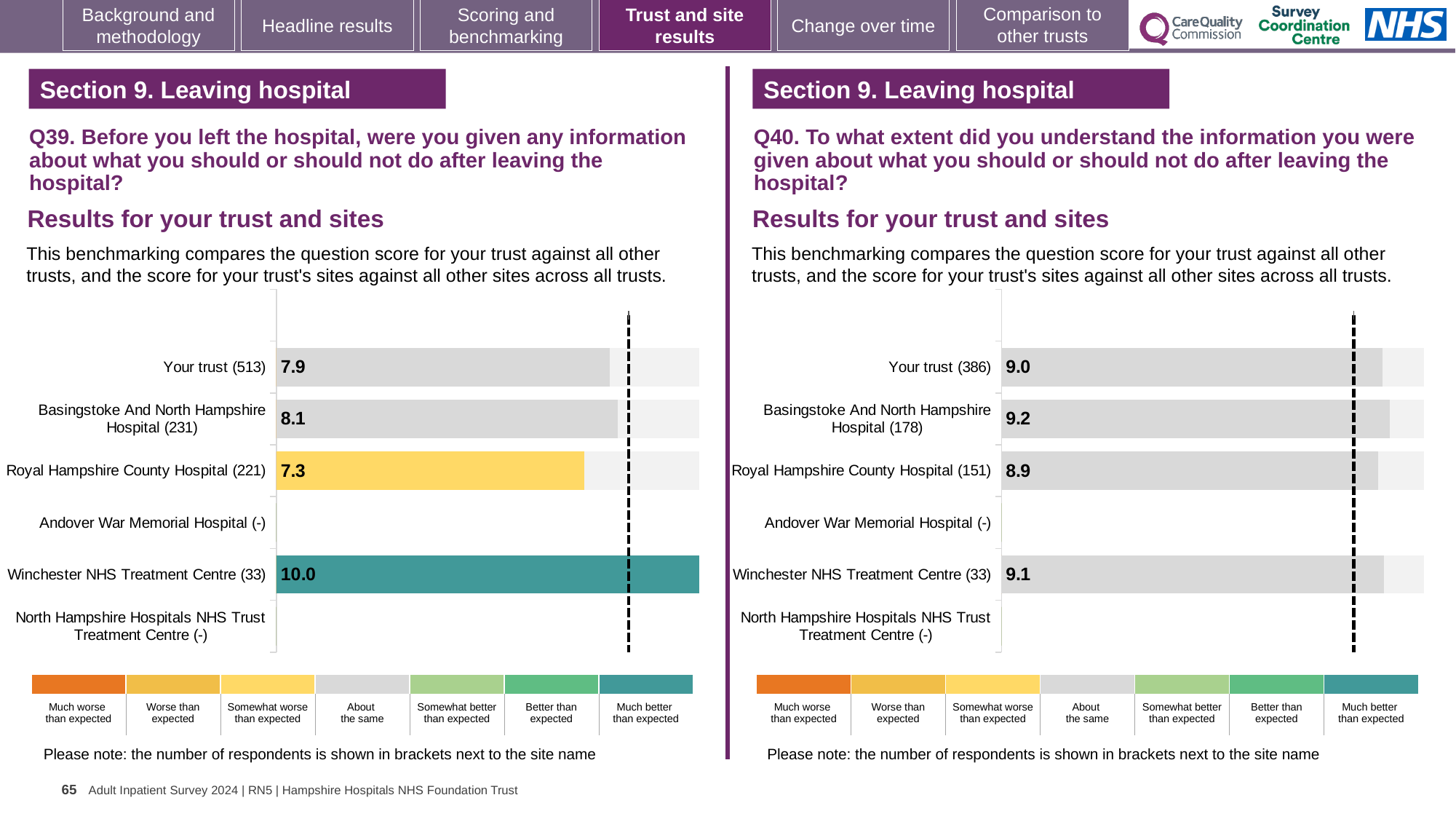
On the Q39 chart (left), what is the difference between the scores for Winchester NHS Treatment Centre (33) and Your trust (513)? 2.1 On the Q40 chart (right), what is the score for Basingstoke And North Hampshire Hospital (178)? 9.2 On the Q40 chart (right), what is the difference between the scores for Basingstoke And North Hampshire Hospital (178) and Royal Hampshire County Hospital (151)? 0.3 On the Q40 chart (right), which is larger: the score for Your trust (386) or the score for Royal Hampshire County Hospital (151)? Your trust (386) On the Q39 chart (left), what is the score for Your trust (513)? 7.9 On the Q40 chart (right), which site has the highest score? Basingstoke And North Hampshire Hospital (178) On the Q39 chart (left), which site has the highest score? Winchester NHS Treatment Centre (33) On the Q39 chart (left), which site with a score shown has the lowest score? Royal Hampshire County Hospital (221) What kind of chart is used on the Q39 chart (left)? Bar chart On the Q39 chart (left), what colour is the bar for Royal Hampshire County Hospital (221)? Yellow On the Q39 chart (left), what is the score for Royal Hampshire County Hospital (221)? 7.3 On the Q40 chart (right), what is the score for Winchester NHS Treatment Centre (33)? 9.1